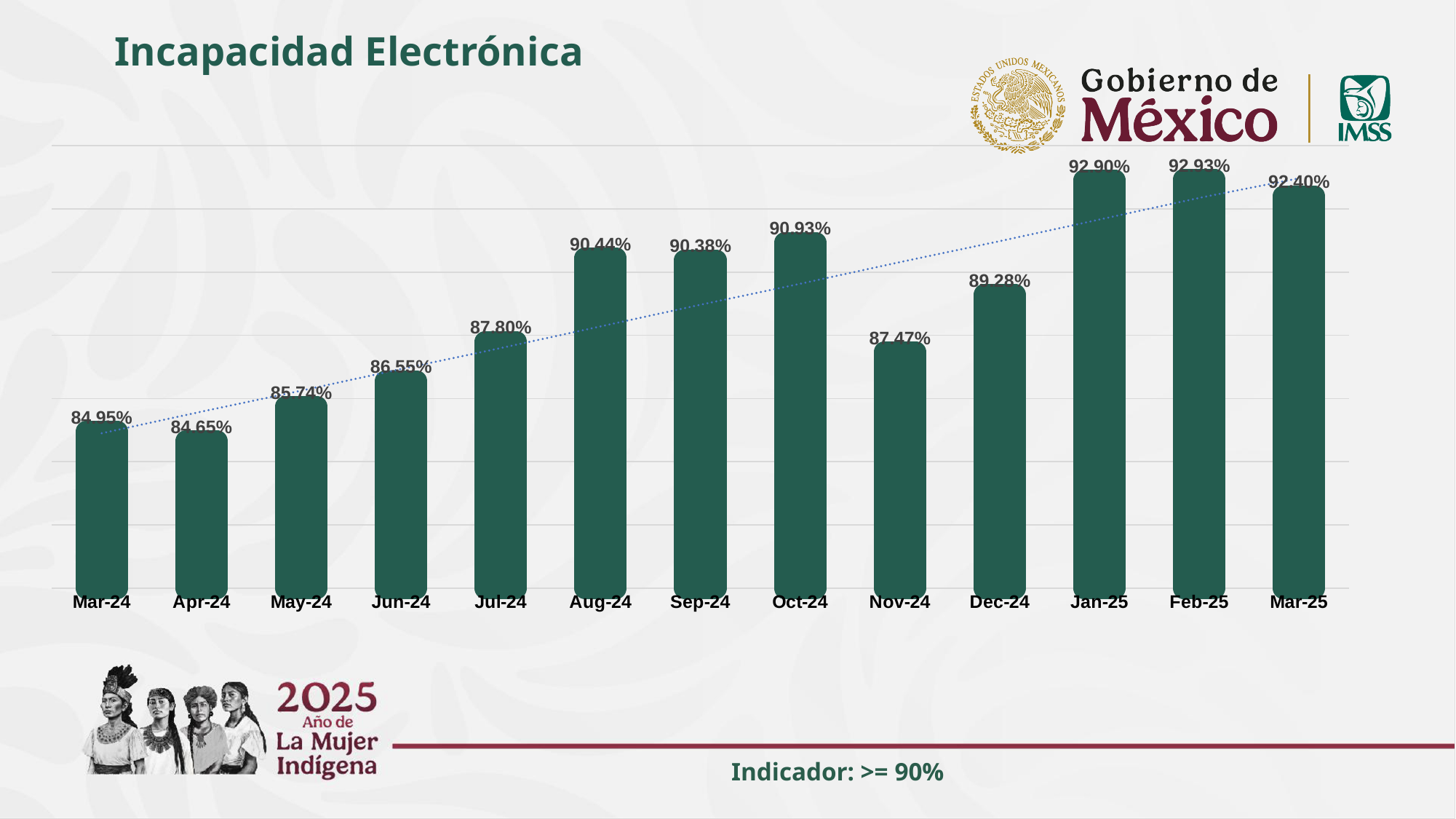
What is the value for Mar-25? 92.40% How many months are shown on the x axis? 13 What is the value for Feb-25? 92.93% What kind of chart is shown on the slide? Bar chart What is the value for Nov-24? 87.47% What is the difference between the value for Jan-25 and the value for Dec-24? 3.62 percentage points What is the difference between the value for Mar-25 and the value for Mar-24? 7.45 percentage points Do the values generally rise or fall from Mar-24 to Mar-25? Rise Which is larger, the value for Aug-24 or the value for Nov-24? Aug-24 Which is larger, the value for Jul-24 or the value for Dec-24? Dec-24 What is the value for Mar-24? 84.95% What is the value for Oct-24? 90.93%